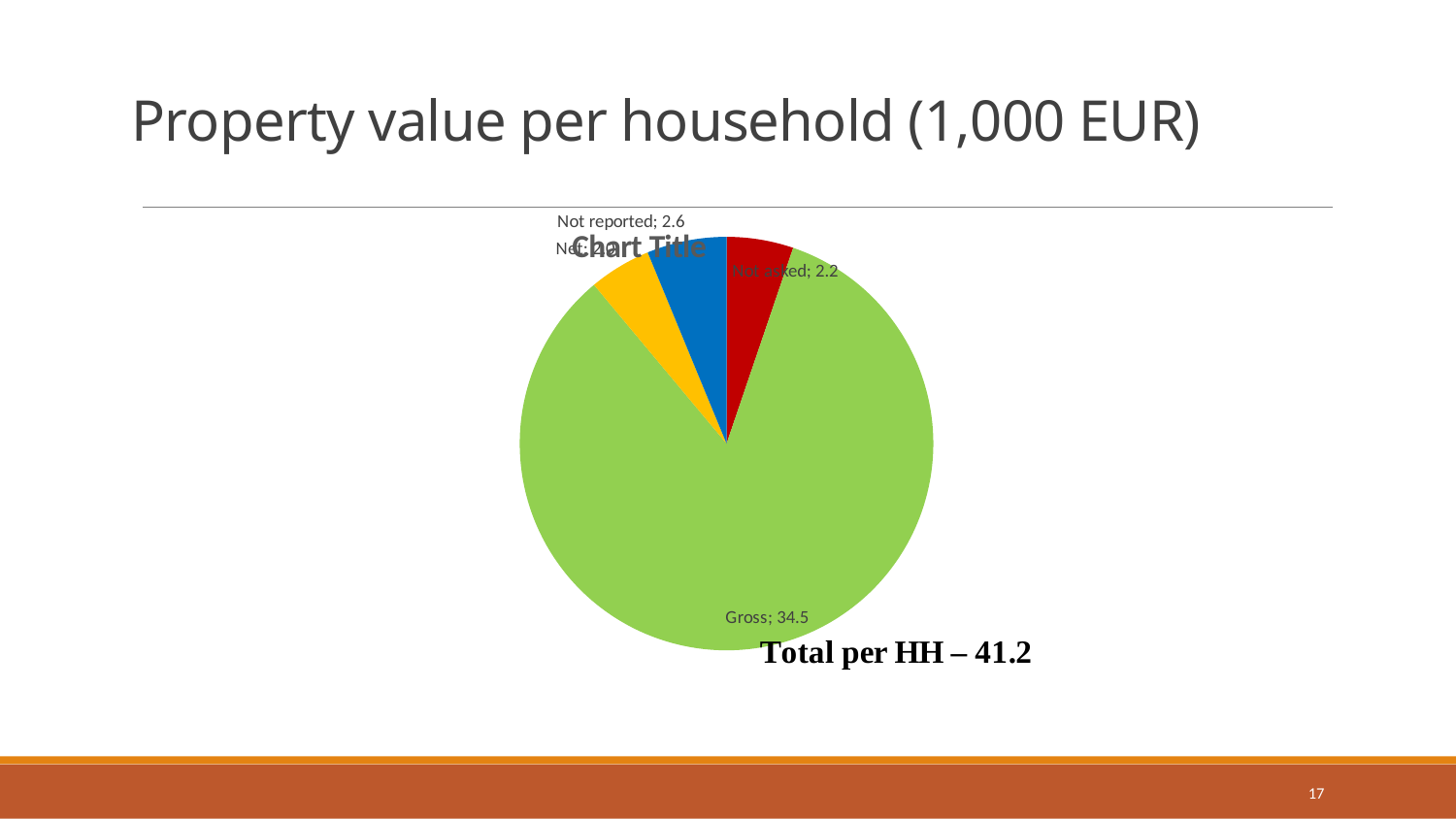
What colour is the Gross slice of the pie chart? green What is the value for Not asked in the pie chart? 2.2 Which is larger, the value for Not reported or the value for Not asked? Not reported What is the difference between the value for Gross and the value for Not reported? 31.9 What is the value for Not reported in the pie chart? 2.6 Which category has the largest slice of the pie chart? Gross What total per household is stated below the pie chart? 41.2 How many slices does the pie chart have? 4 What is the value for Gross in the pie chart? 34.5 What kind of chart is shown on the slide? pie chart What is the difference between the value for Not reported and the value for Not asked? 0.4